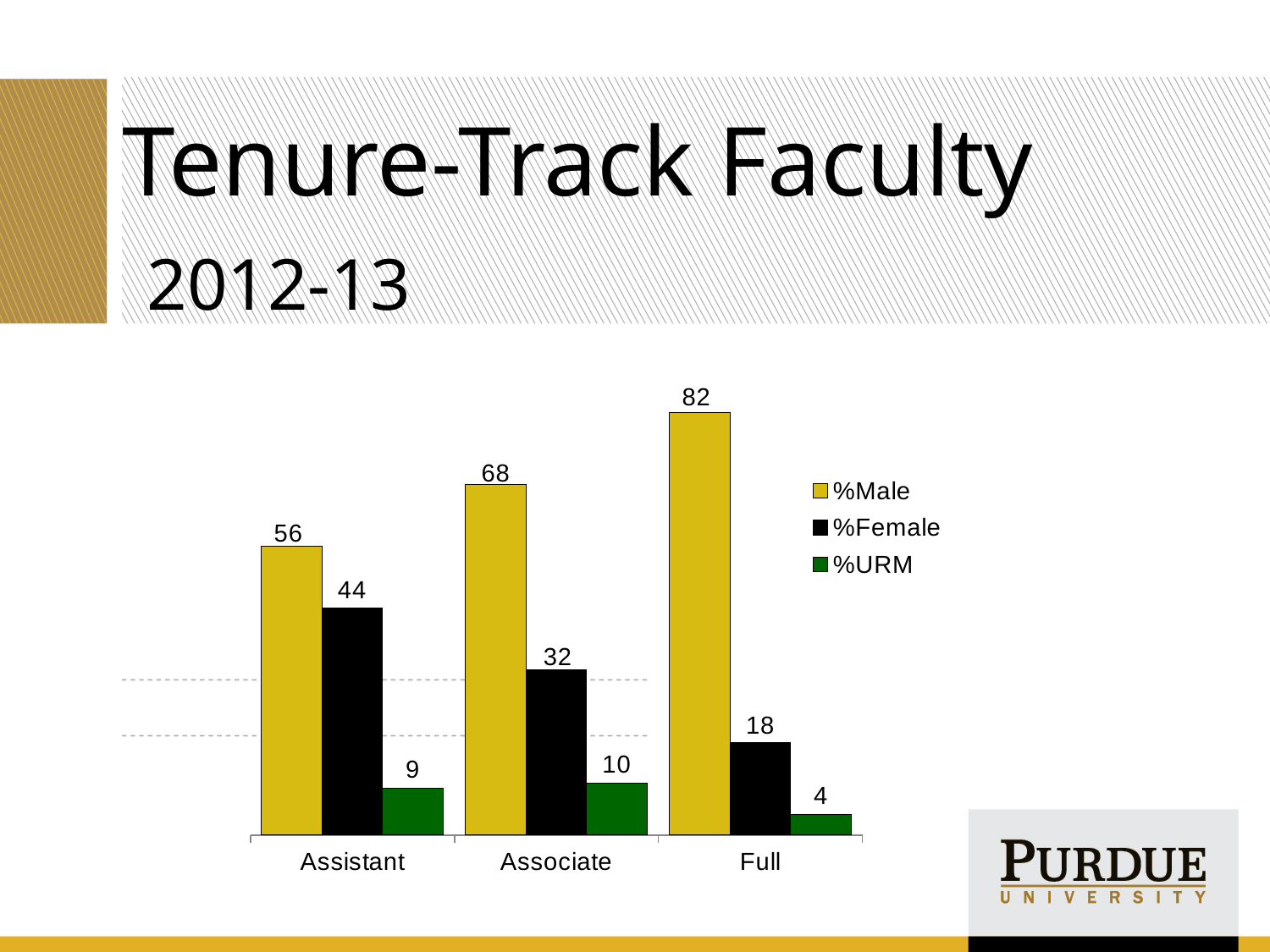
What kind of chart is shown on the slide? Bar chart Which rank has the lowest %URM value? Full What is the difference between the %Male and %Female values for Associate faculty? 36 How many series does the legend list? 3 Which rank has the highest %Male value? Full What is the %URM value for Associate faculty? 10 Does the %Female value rise or fall from Assistant to Full? Fall Is the %Female value larger for Assistant or Full faculty? Assistant How many faculty ranks are shown on the x axis? 3 What is the %Female value for Assistant faculty? 44 What is the %Male value for Full faculty? 82 Which series is shown in green in the legend? %URM